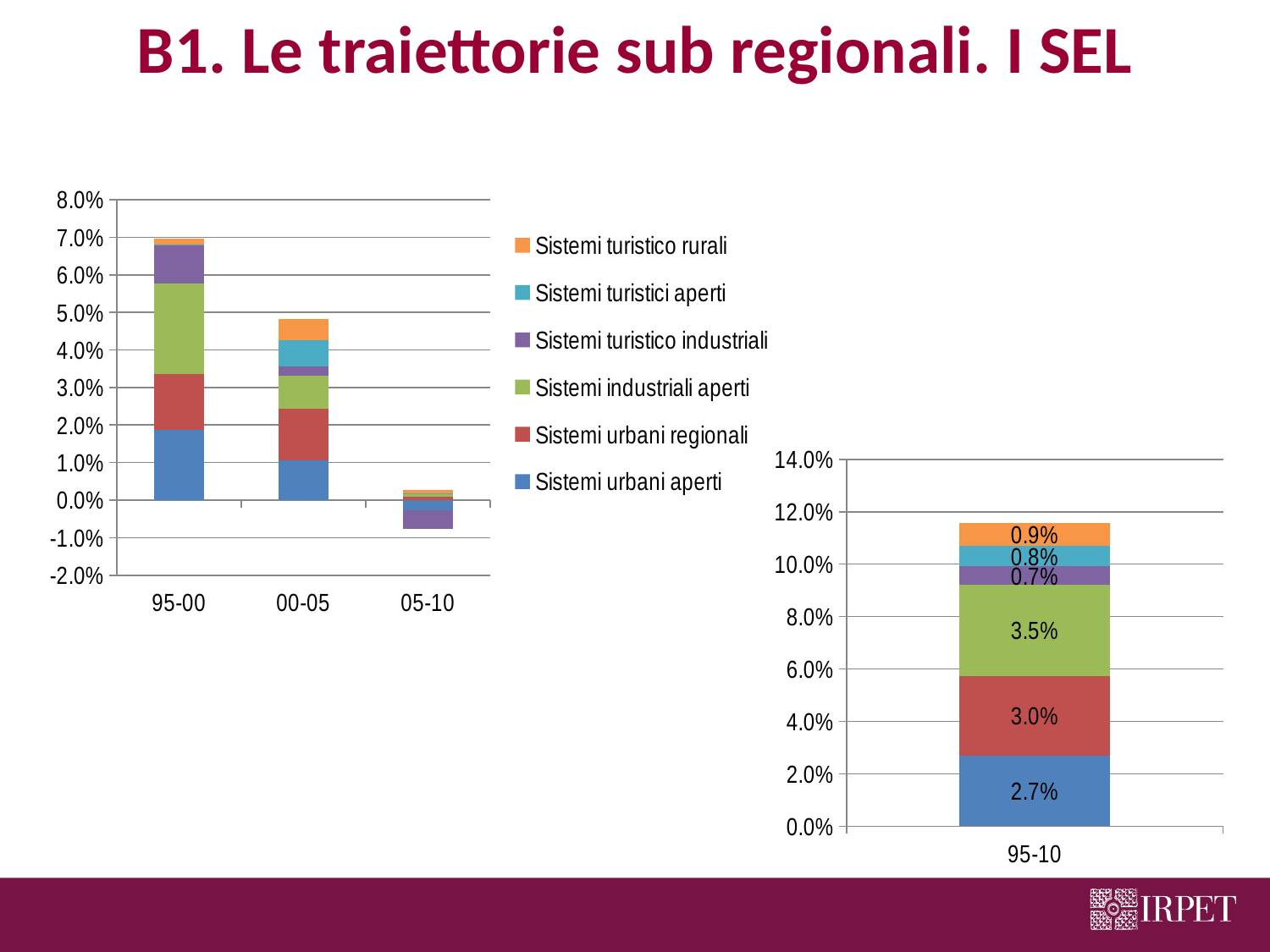
In the right-hand chart (95-10), what is the difference between the green segment (3.5%) and the red segment (3.0%)? 0.5 percentage points How many series does the legend list? 6 In the right-hand chart (95-10), what is the value of the blue segment, Sistemi urbani aperti? 2.7% How many periods are shown on the x axis of the left-hand chart? 3 In the left-hand chart, is the total height of the 95-00 bar greater or less than 6.0%? greater In the right-hand chart (95-10), what is the value of the orange segment, Sistemi turistico rurali? 0.9% In the right-hand chart (95-10), what is the value of the green segment, Sistemi industriali aperti? 3.5% In the right-hand chart, what is the total of the stacked bar for 95-10? 11.6% In the left-hand chart, which period has the taller stacked bar, 95-00 or 00-05? 95-00 In the right-hand chart (95-10), which segment has the largest value? Sistemi industriali aperti (green), 3.5% In the right-hand chart (95-10), which segment has the smallest value? Sistemi turistico industriali (purple), 0.7% What kind of chart is the left-hand chart? Stacked bar chart